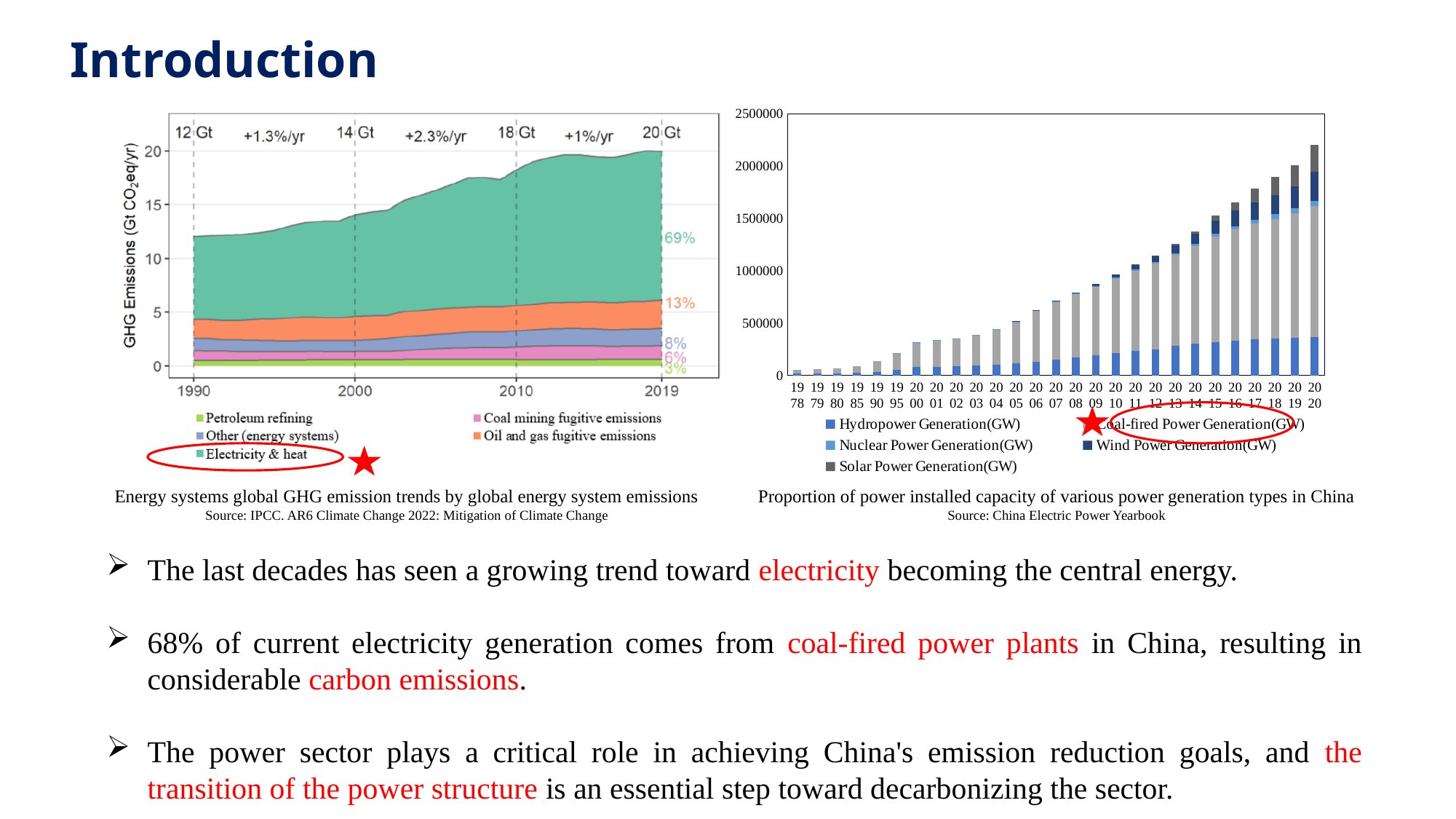
In the left chart (Energy systems global GHG emission trends), which category has the smallest labelled share? Petroleum refining In the left chart (Energy systems global GHG emission trends), by how many Gt did total emissions increase from 2010 to 2019 according to the labels? 2 Gt In the left chart (Energy systems global GHG emission trends), what was the total GHG emissions value labelled for 2019? 20 Gt In the left chart (Energy systems global GHG emission trends), what was the total GHG emissions value labelled for 1990? 12 Gt What kind of chart is the right chart (Proportion of power installed capacity of various power generation types in China)? Stacked bar chart In the right chart (Proportion of power installed capacity in China), is the total stacked value for 2020 greater or less than 2000000? greater In the left chart (Energy systems global GHG emission trends), what annual growth rate is shown between 2000 and 2010? +2.3%/yr In the right chart (Proportion of power installed capacity in China), how many series does the legend list? 5 In the right chart (Proportion of power installed capacity in China), do the total stacked values generally rise or fall from 1978 to 2020? rise In the left chart (Energy systems global GHG emission trends), what share of emissions is labelled for Electricity & heat? 69% In the left chart (Energy systems global GHG emission trends), what share of emissions is labelled for Oil and gas fugitive emissions? 13% In the left chart (Energy systems global GHG emission trends), how many categories does the legend list? 5